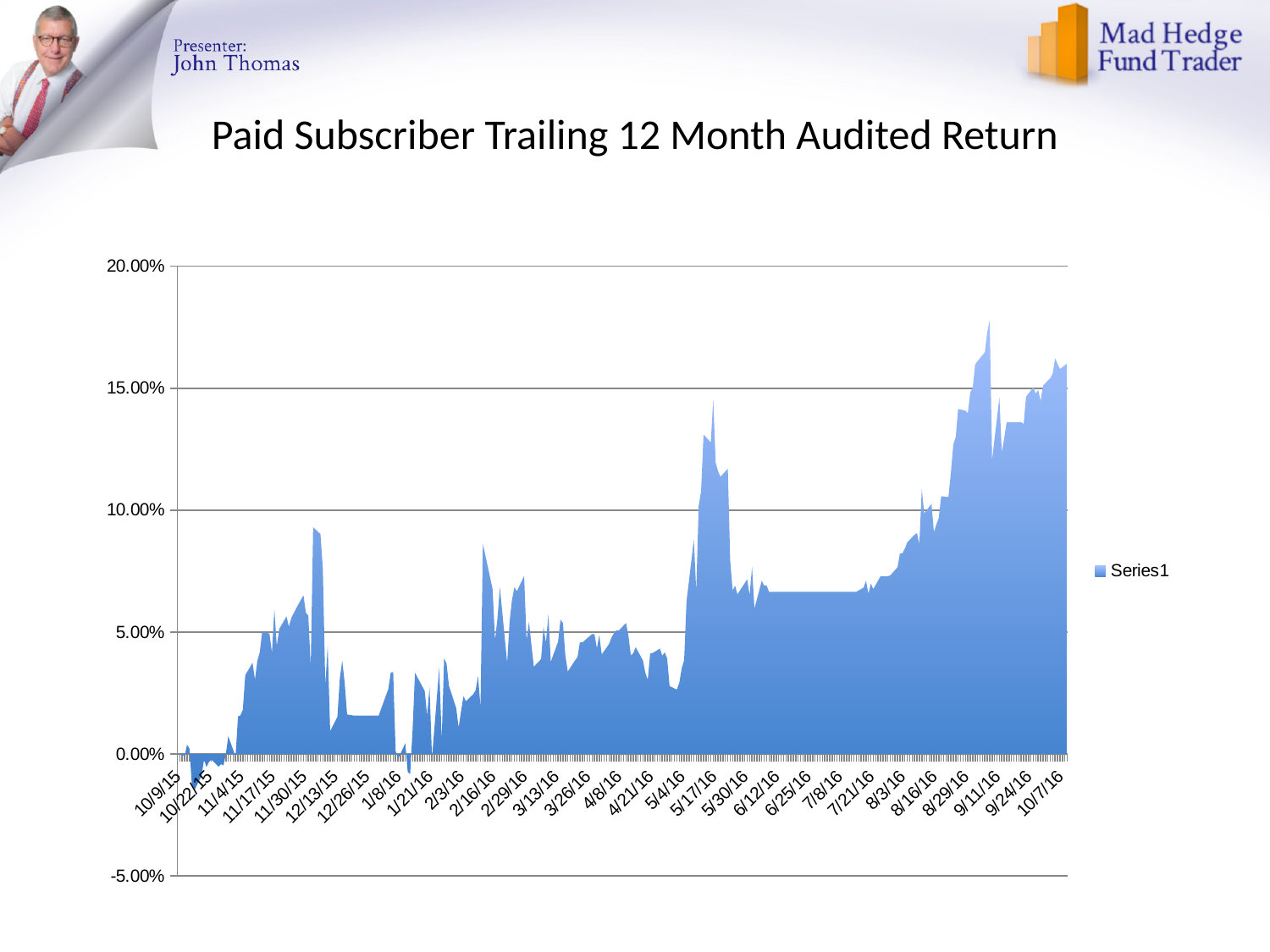
What is the name of the series shown in the legend? Series1 Which is larger, the value at 6/12/16 or the value at 9/11/16? 9/11/16 Is the value at 1/8/16 greater or less than 5.00%? less Overall, do the values rise or fall from 10/9/15 to 10/7/16? rise Is the value at 8/3/16 greater or less than 10.00%? less What kind of chart is shown on the slide? area chart Which is larger, the value at 10/9/15 or the value at 10/7/16? 10/7/16 How many series does the legend list? 1 What is the highest value shown on the vertical axis? 20.00% Is the value at 6/12/16 greater or less than 5.00%? greater